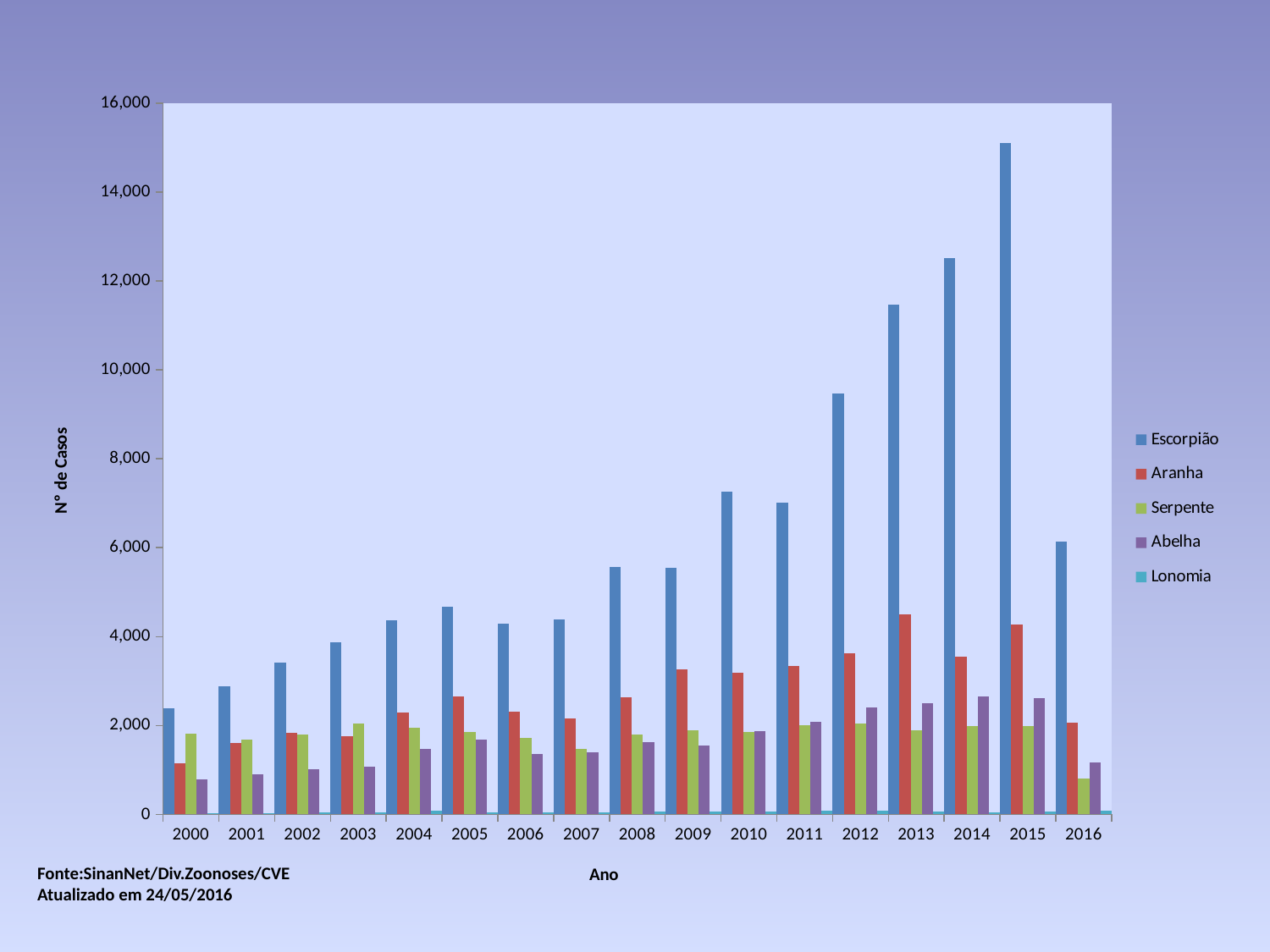
Is the Aranha value for 2013 greater or less than 4,000? greater What is the title of the vertical axis? N° de Casos In 2013, which is larger, the Aranha value or the Serpente value? Aranha In which year is the Escorpião value highest? 2015 What kind of chart is shown on the slide? bar chart How many years are shown on the x axis? 17 Is the Escorpião value for 2012 greater or less than 10,000? less How many series does the legend list? 5 Which year has the larger Escorpião value, 2014 or 2016? 2014 What is the title of the horizontal axis? Ano Is the Escorpião value for 2015 greater or less than 14,000? greater In which year is the Abelha value lowest? 2000